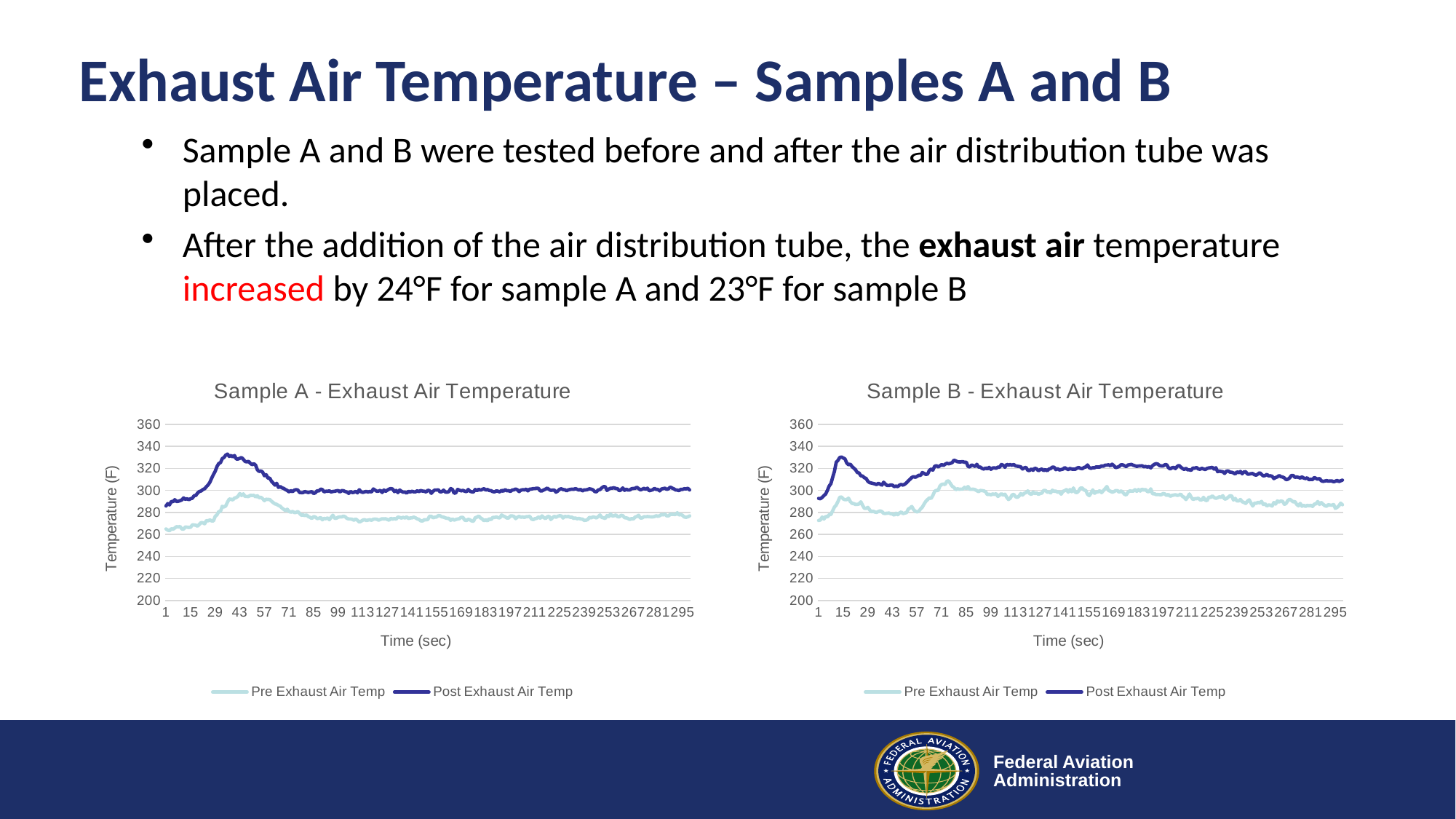
What is the y-axis label on the "Sample A - Exhaust Air Temperature" chart? Temperature (F) In the "Sample B - Exhaust Air Temperature" chart, which series is higher throughout, Pre Exhaust Air Temp or Post Exhaust Air Temp? Post Exhaust Air Temp In the "Sample B - Exhaust Air Temperature" chart, is the Pre Exhaust Air Temp value at time 1 greater or less than 280? less In the "Sample A - Exhaust Air Temperature" chart, is the peak of the Post Exhaust Air Temp series greater or less than 320? greater In the "Sample A - Exhaust Air Temperature" chart, which series is higher throughout, Pre Exhaust Air Temp or Post Exhaust Air Temp? Post Exhaust Air Temp What kind of chart is the "Sample A - Exhaust Air Temperature" chart? line chart In the "Sample A - Exhaust Air Temperature" chart, is the Pre Exhaust Air Temp value at time 1 greater or less than 280? less In the "Sample B - Exhaust Air Temperature" chart, does the Post Exhaust Air Temp series rise or fall between time 211 and time 295? fall How many series does the legend of the "Sample B - Exhaust Air Temperature" chart list? 2 What is the x-axis label on the "Sample B - Exhaust Air Temperature" chart? Time (sec)